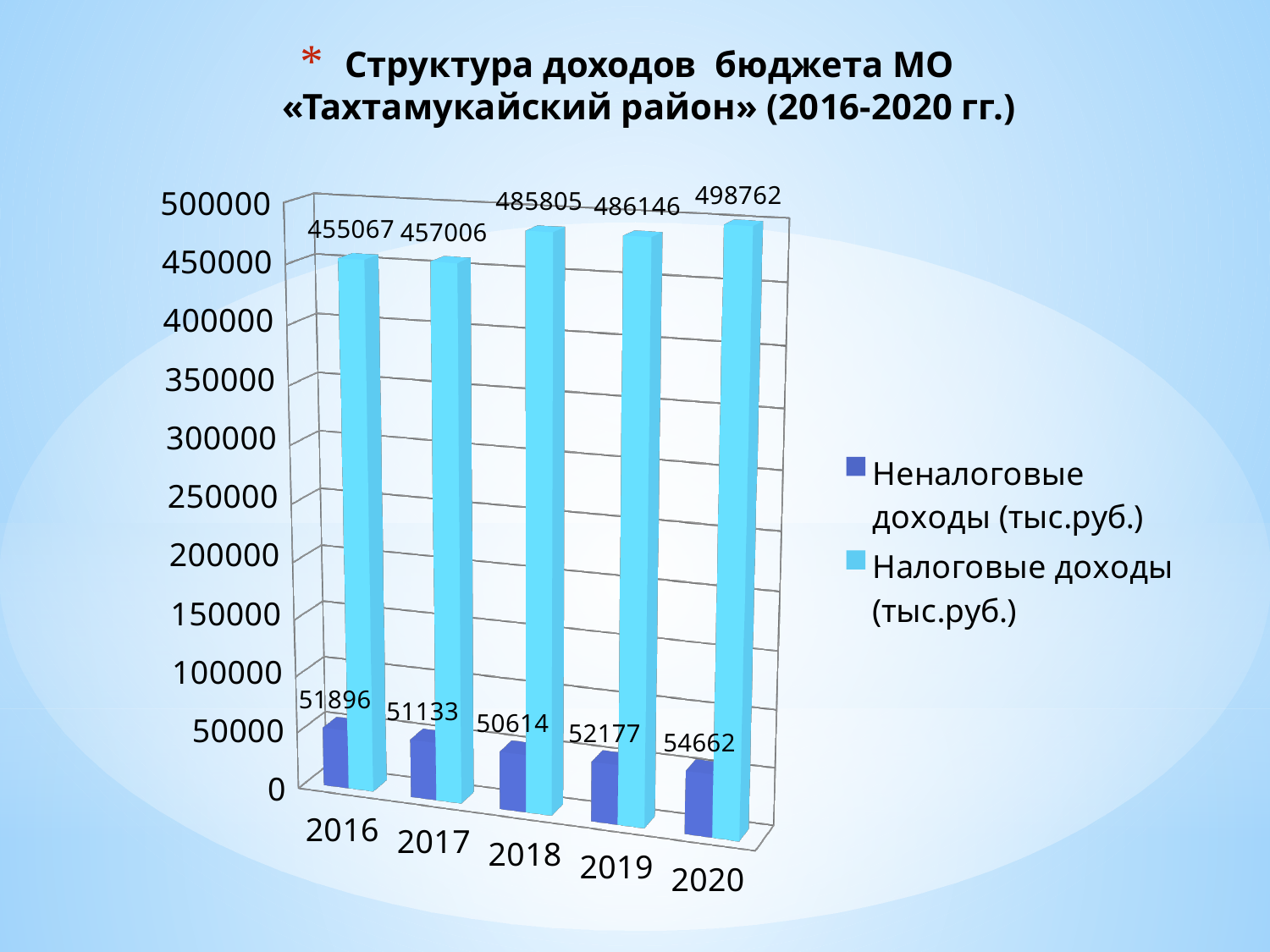
What is the difference between Налоговые доходы in 2020 and in 2016? 43695 What is the value of Налоговые доходы (тыс.руб.) for 2018? 485805 What kind of chart is shown on the slide? Bar chart In which year are Неналоговые доходы (тыс.руб.) the lowest? 2018 How many years are shown on the x axis? 5 What is the value of Налоговые доходы (тыс.руб.) for 2016? 455067 In which year are Налоговые доходы (тыс.руб.) the highest? 2020 Which is larger: Неналоговые доходы in 2016 or in 2017? 2016 What is the value of Неналоговые доходы (тыс.руб.) for 2019? 52177 What is the difference between Неналоговые доходы in 2020 and in 2018? 4048 Do Налоговые доходы (тыс.руб.) rise or fall from 2016 to 2020? Rise How many series does the legend list? 2